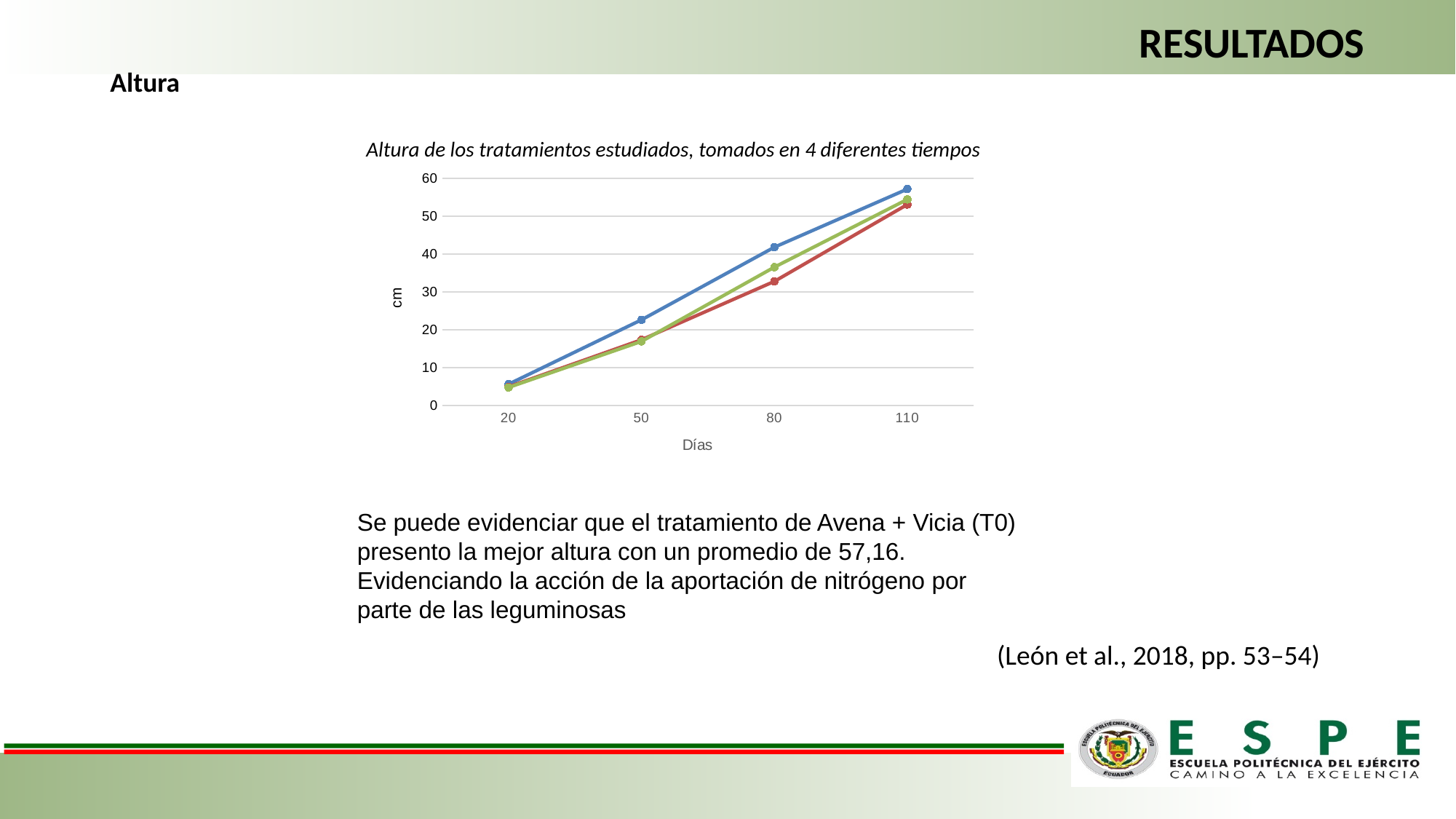
Is the value of the red line at 80 days greater or less than 40? less Is the value of the blue line at 110 days greater or less than 50? greater Is the value of the red line at 50 days greater or less than 20? less How many lines are plotted on the chart? 3 Do the values of the lines rise or fall as the days increase along the x axis? rise Which line has the highest value at 80 days? the blue line What is the label of the x axis of the chart? Días How many time points (days) are shown on the x axis of the chart? 4 What is the title of the chart? Altura de los tratamientos estudiados, tomados en 4 diferentes tiempos At 80 days, which is larger: the value of the green line or the value of the red line? the green line What kind of chart is shown on the slide? line chart